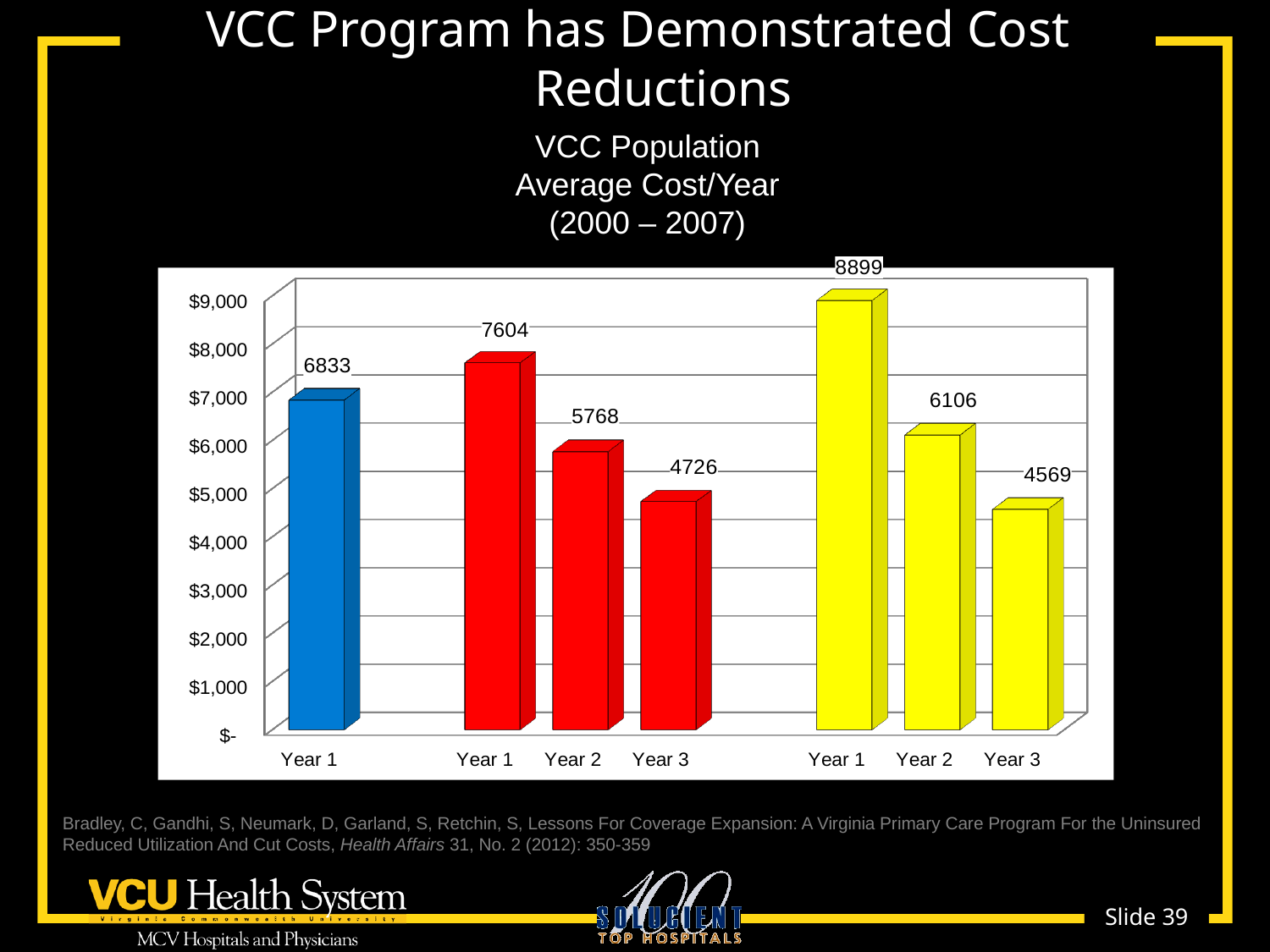
What kind of chart is shown on the slide? bar chart How many bars are plotted on the chart? 7 Which is larger, the Year 2 value in the red group or the Year 2 value in the yellow group? Year 2 in the yellow group (6106) What is the value of the Year 3 bar in the red group? 4726 Which bar has the highest value on the chart? Year 1 in the yellow group (8899) Do the values in the yellow group rise or fall from Year 1 to Year 3? fall What is the value of the Year 2 bar in the yellow group? 6106 What is the value of the Year 1 bar in the yellow group? 8899 Which bar has the lowest value on the chart? Year 3 in the yellow group (4569) What is the difference between the Year 1 and Year 3 values in the yellow group? 4330 What is the difference between the Year 1 and Year 3 values in the red group? 2878 What is the value of the blue bar labelled Year 1? 6833